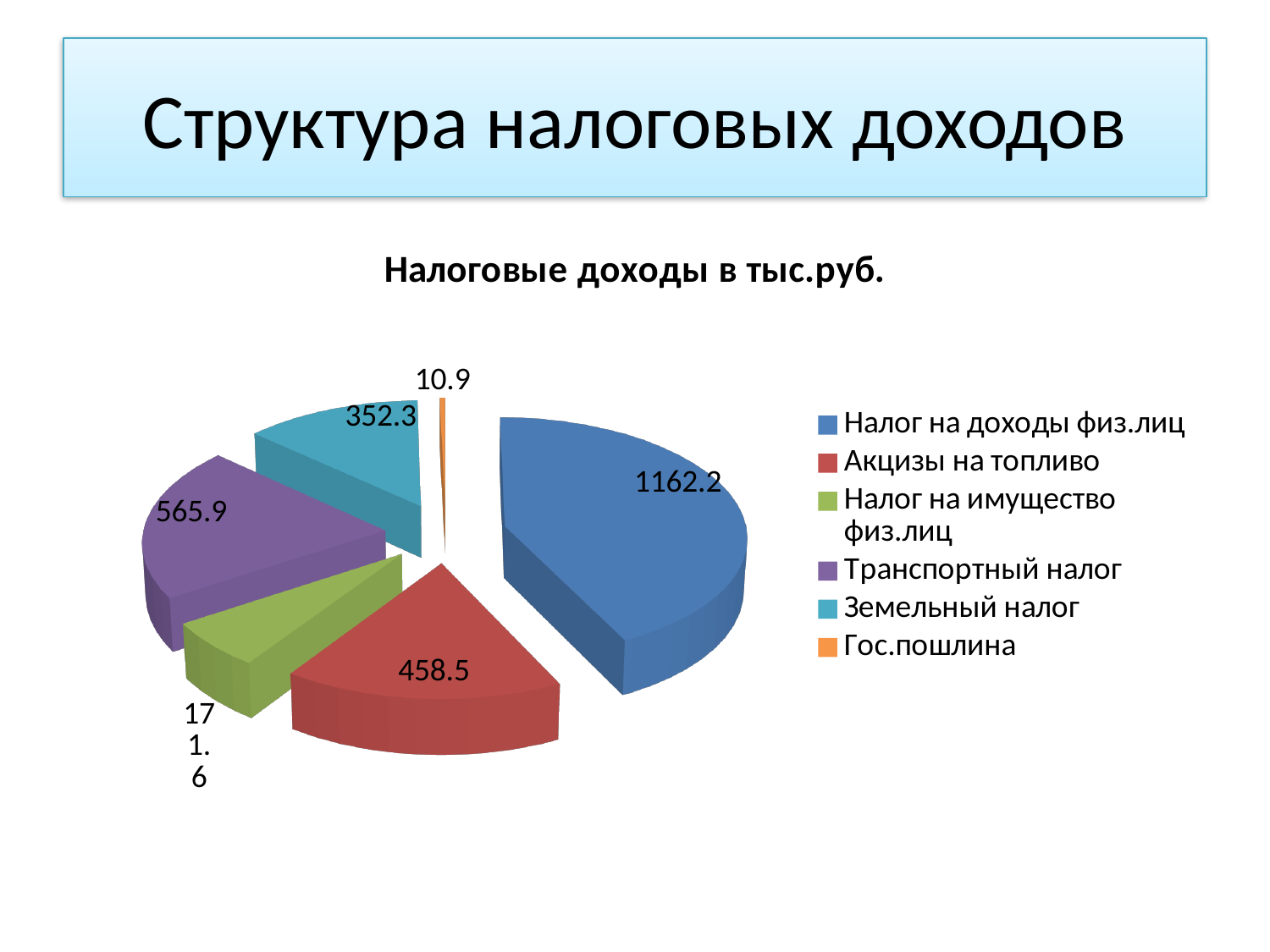
Which is larger, Акцизы на топливо or Налог на имущество физ.лиц? Акцизы на топливо Which category has the largest slice of the pie? Налог на доходы физ.лиц What is the difference between the values for Налог на доходы физ.лиц and Акцизы на топливо? 703.7 What is the value for Налог на доходы физ.лиц? 1162.2 What is the difference between the values for Транспортный налог and Земельный налог? 213.6 What is the value for Транспортный налог? 565.9 What is the value for Гос.пошлина? 10.9 Which category has the smallest slice of the pie? Гос.пошлина How many categories does the pie chart show? 6 What is the title of the chart? Налоговые доходы в тыс.руб. What kind of chart is shown on the slide? Pie chart What is the value for Земельный налог? 352.3